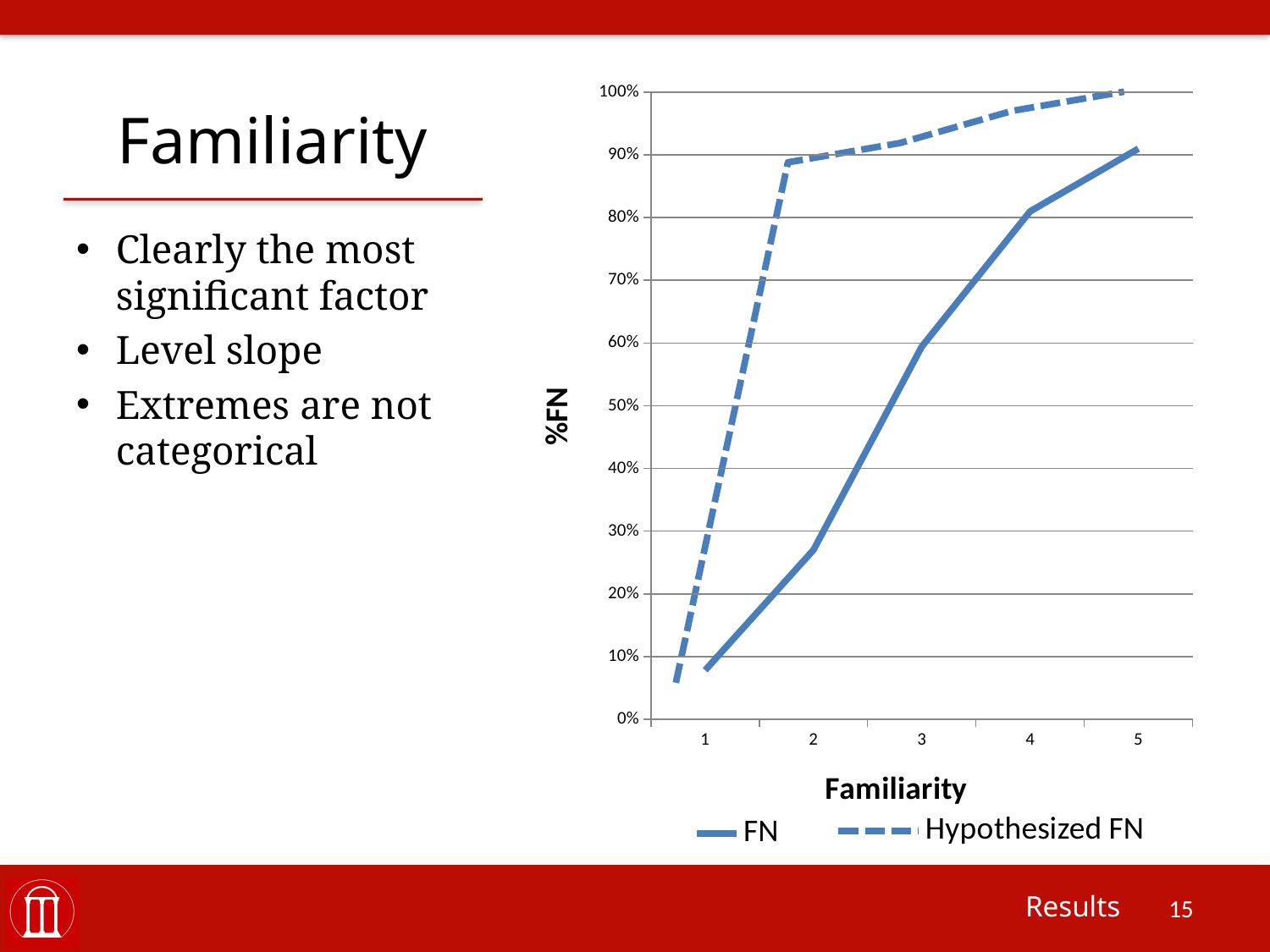
Which series is drawn with a dashed line? Hypothesized FN How many series does the chart legend list? 2 Is the FN value at familiarity 2 greater or less than 40%? less What is the label on the y axis of the chart? %FN How many familiarity levels are plotted along the x axis? 5 Does the FN series rise or fall as familiarity increases from 1 to 5? rise Is the FN value at familiarity 3 greater or less than 50%? greater At familiarity 2, which series has the higher value, FN or Hypothesized FN? Hypothesized FN What kind of chart is shown on the slide? line chart Is the Hypothesized FN value at familiarity 2 greater or less than 80%? greater